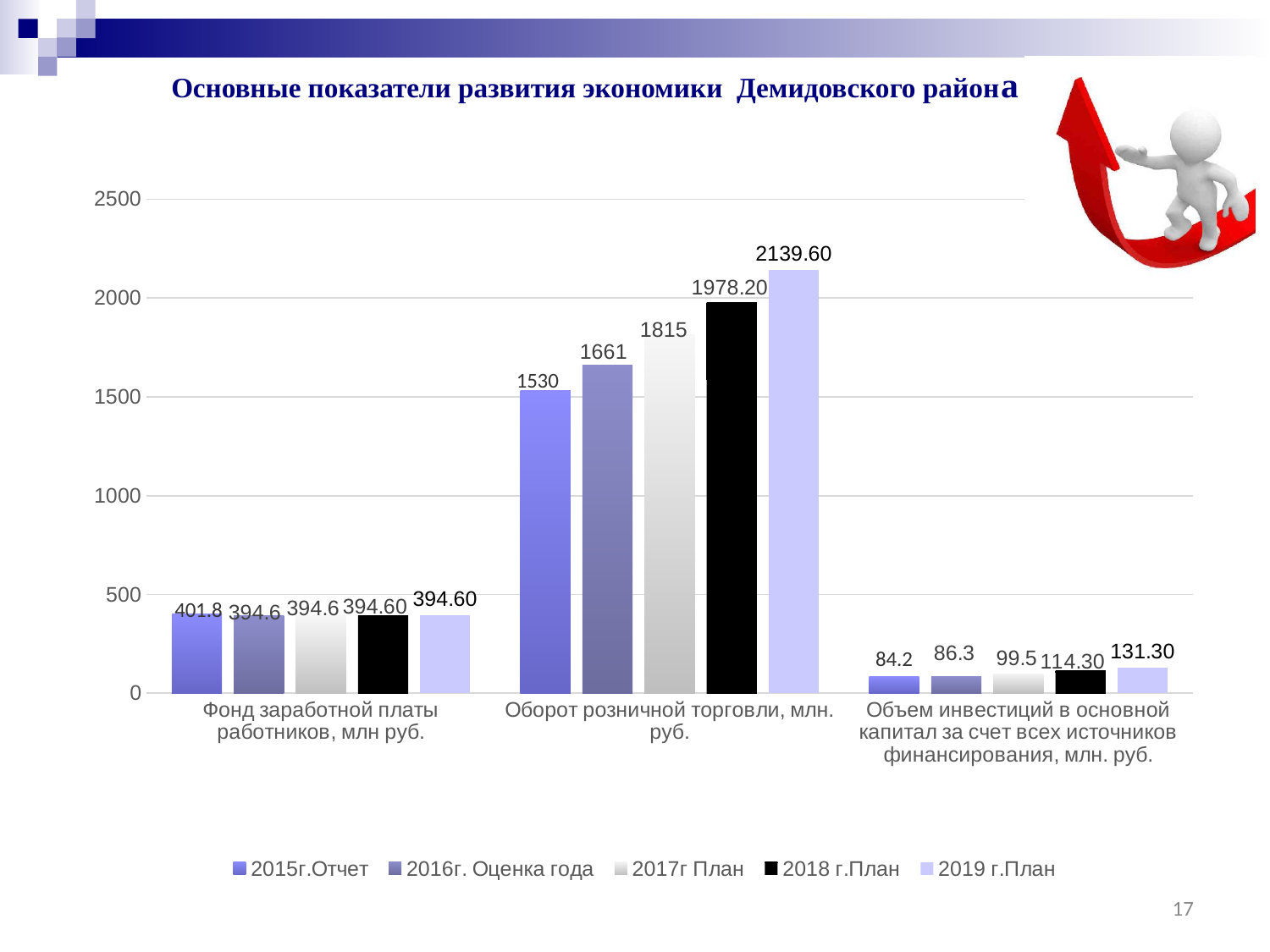
Do the values for Объем инвестиций в основной капитал за счет всех источников финансирования, млн. руб. rise or fall from 2015г.Отчет to 2019 г.План? rise What is the value for 2015г.Отчет in the category Фонд заработной платы работников, млн руб.? 401.8 Which series has the highest value in the category Оборот розничной торговли, млн. руб.? 2019 г.План What is the title of the chart? Основные показатели развития экономики Демидовского района How many series does the legend list? 5 What is the difference between the 2019 г.План and 2015г.Отчет values in the category Оборот розничной торговли, млн. руб.? 609.60 What is the value for 2017г План in the category Объем инвестиций в основной капитал за счет всех источников финансирования, млн. руб.? 99.5 Which series has the lowest value in the category Объем инвестиций в основной капитал за счет всех источников финансирования, млн. руб.? 2015г.Отчет What is the value for 2019 г.План in the category Оборот розничной торговли, млн. руб.? 2139.60 What is the value for 2018 г.План in the category Оборот розничной торговли, млн. руб.? 1978.20 What type of chart is shown on the slide? bar chart How many categories are shown on the x axis? 3